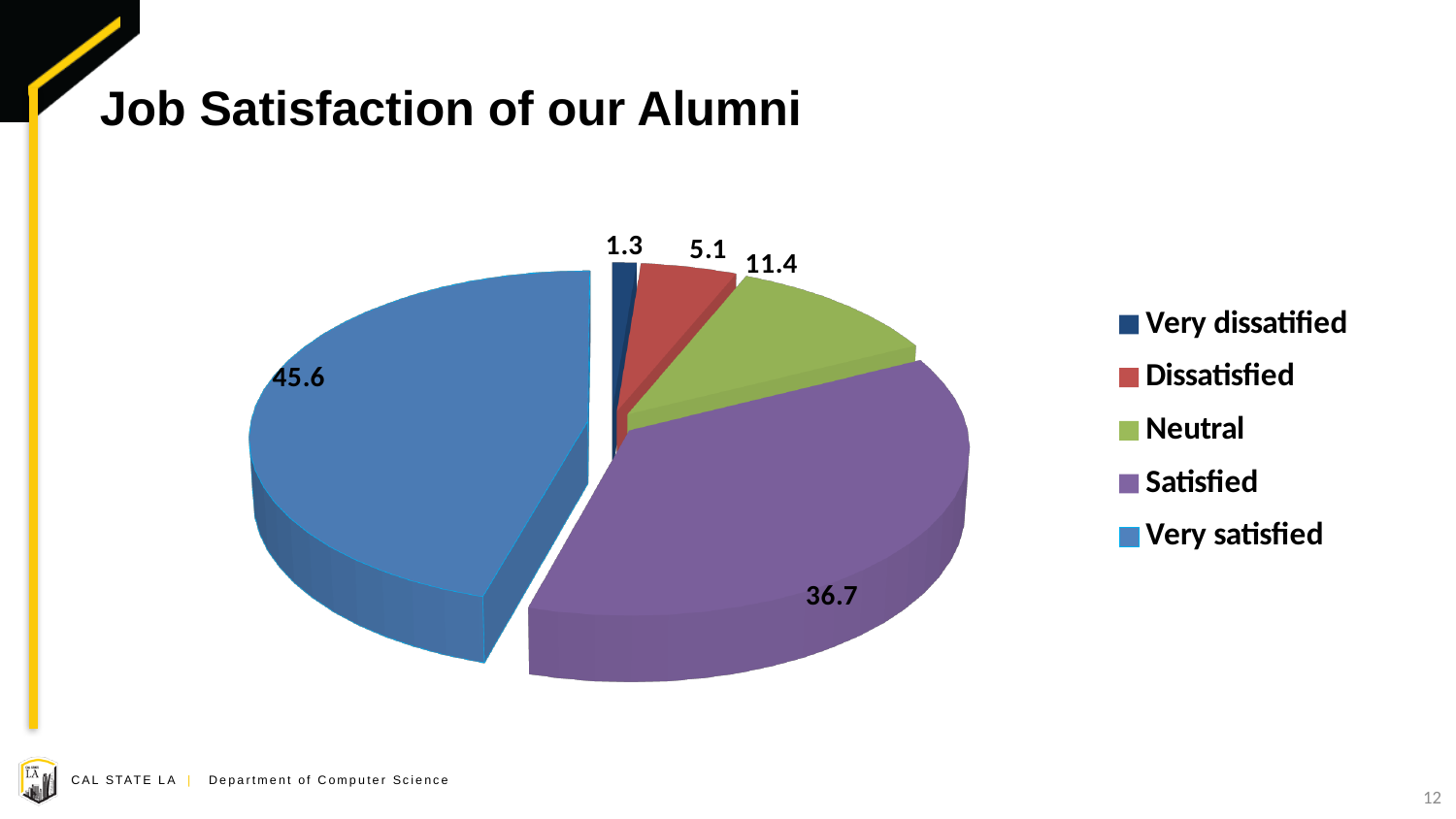
What is the value for Satisfied? 36.7 What kind of chart is shown on the slide? Pie chart What is the value for Very dissatisfied? 1.3 What is the value for Neutral? 11.4 What is the title of the slide containing the chart? Job Satisfaction of our Alumni Which category has the largest slice? Very satisfied What is the difference between the values for Very satisfied and Satisfied? 8.9 Which category has the smallest slice? Very dissatisfied Which is larger, the value for Neutral or the value for Dissatisfied? Neutral What is the value for Very satisfied? 45.6 How many categories does the legend list? 5 What is the value for Dissatisfied? 5.1